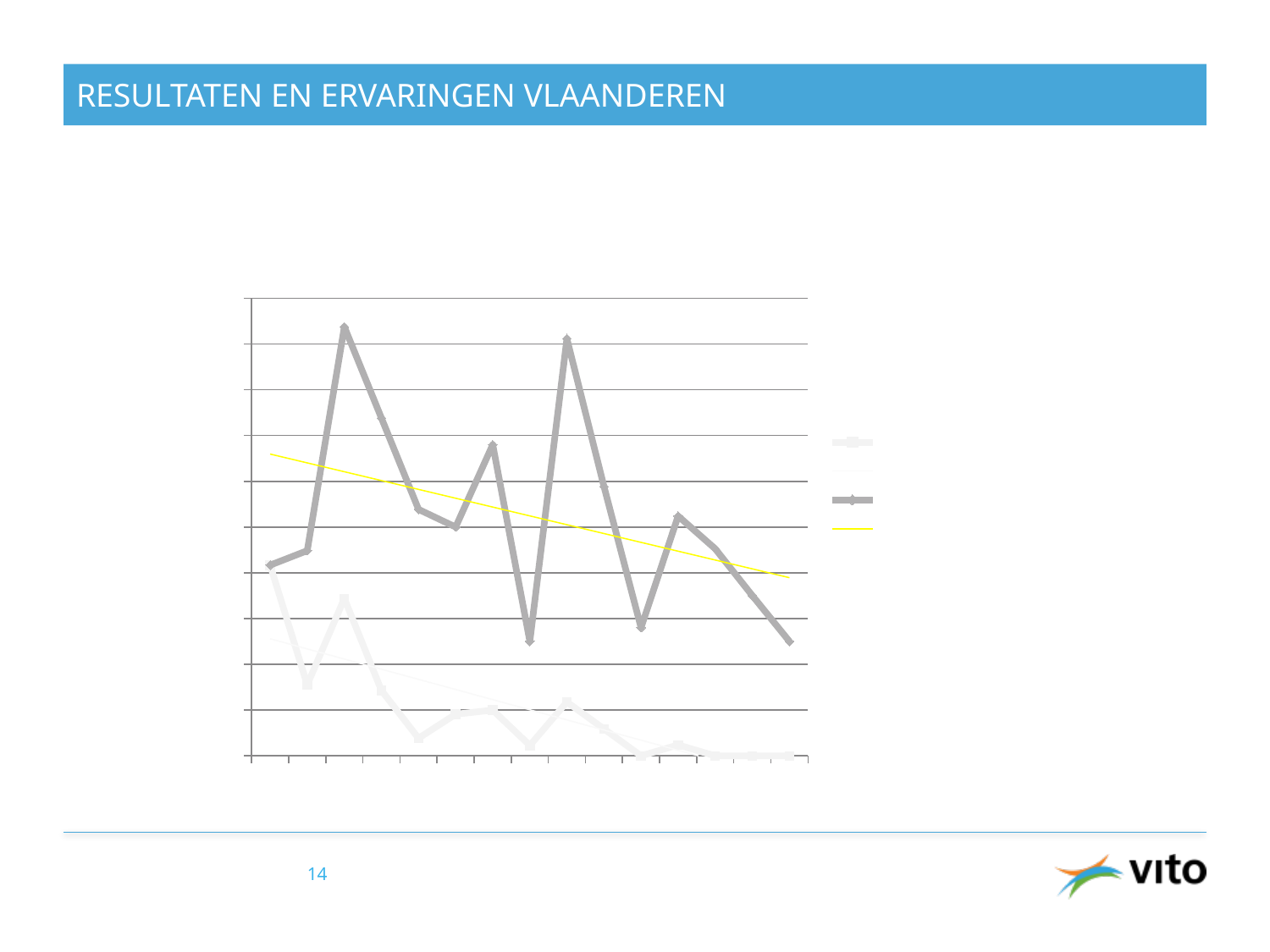
Does the yellow trend line rise or fall from left to right? fall Are any data labels printed on the chart? no What kind of chart is shown on the slide? line chart How many data points does the dark grey line have? 15 Does the light grey line overall rise or fall from left to right? fall What colour is the straight trend line drawn across the dark grey series? yellow How many entries does the legend list? 3